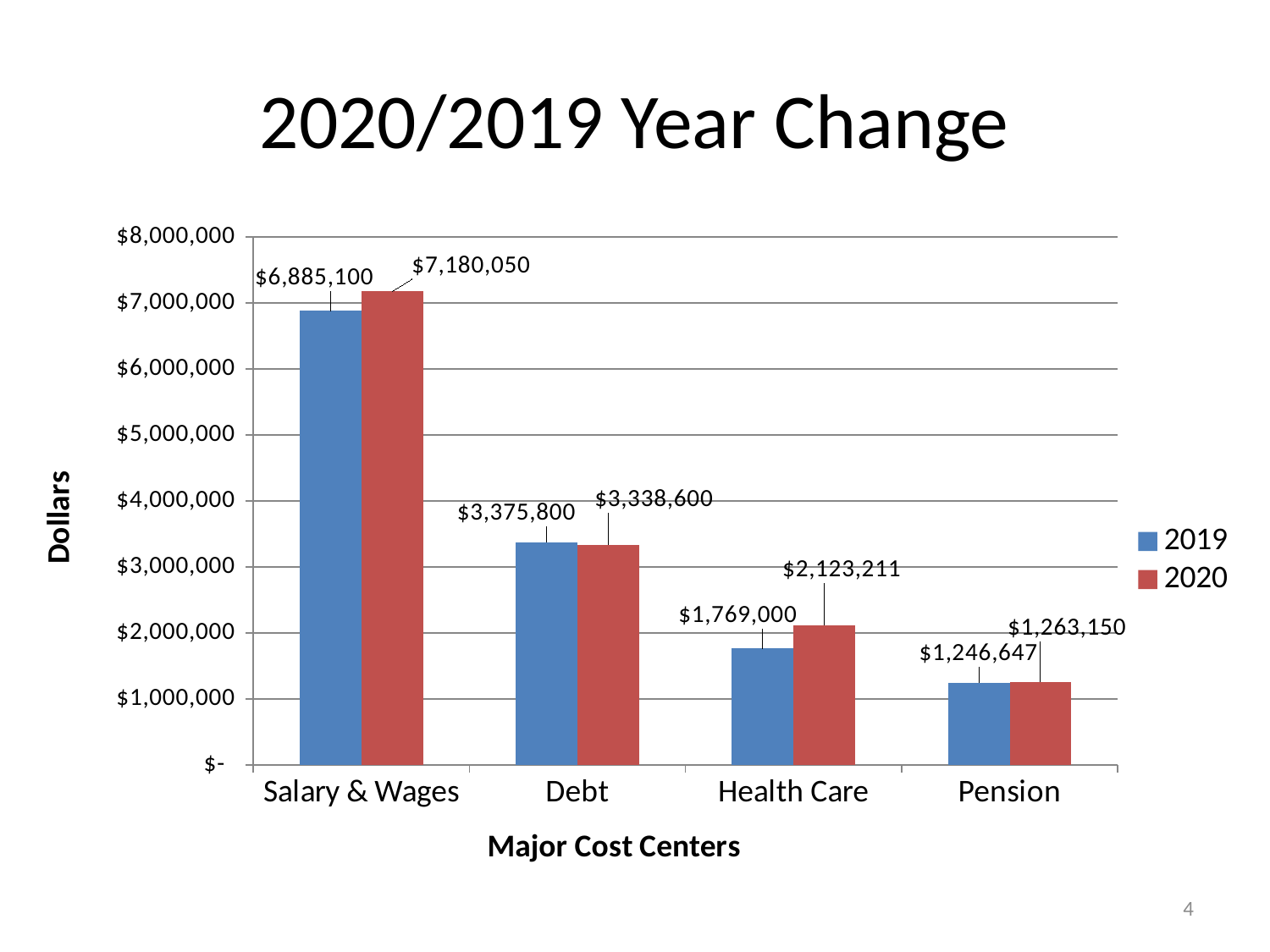
Which cost center has the highest 2020 value? Salary & Wages How many series does the legend list? 2 Which cost center has the lowest 2019 value? Pension What is the 2019 value for Salary & Wages? $6,885,100 What type of chart is shown on the slide? Bar chart What is the 2020 value for Debt? $3,338,600 What is the difference between the 2020 and 2019 values for Health Care? $354,211 What is the 2020 value for Health Care? $2,123,211 What is the 2019 value for Pension? $1,246,647 For Health Care, which year has the larger value, 2019 or 2020? 2020 How many cost centers are shown on the x axis? 4 What is the difference between the 2020 and 2019 values for Salary & Wages? $294,950